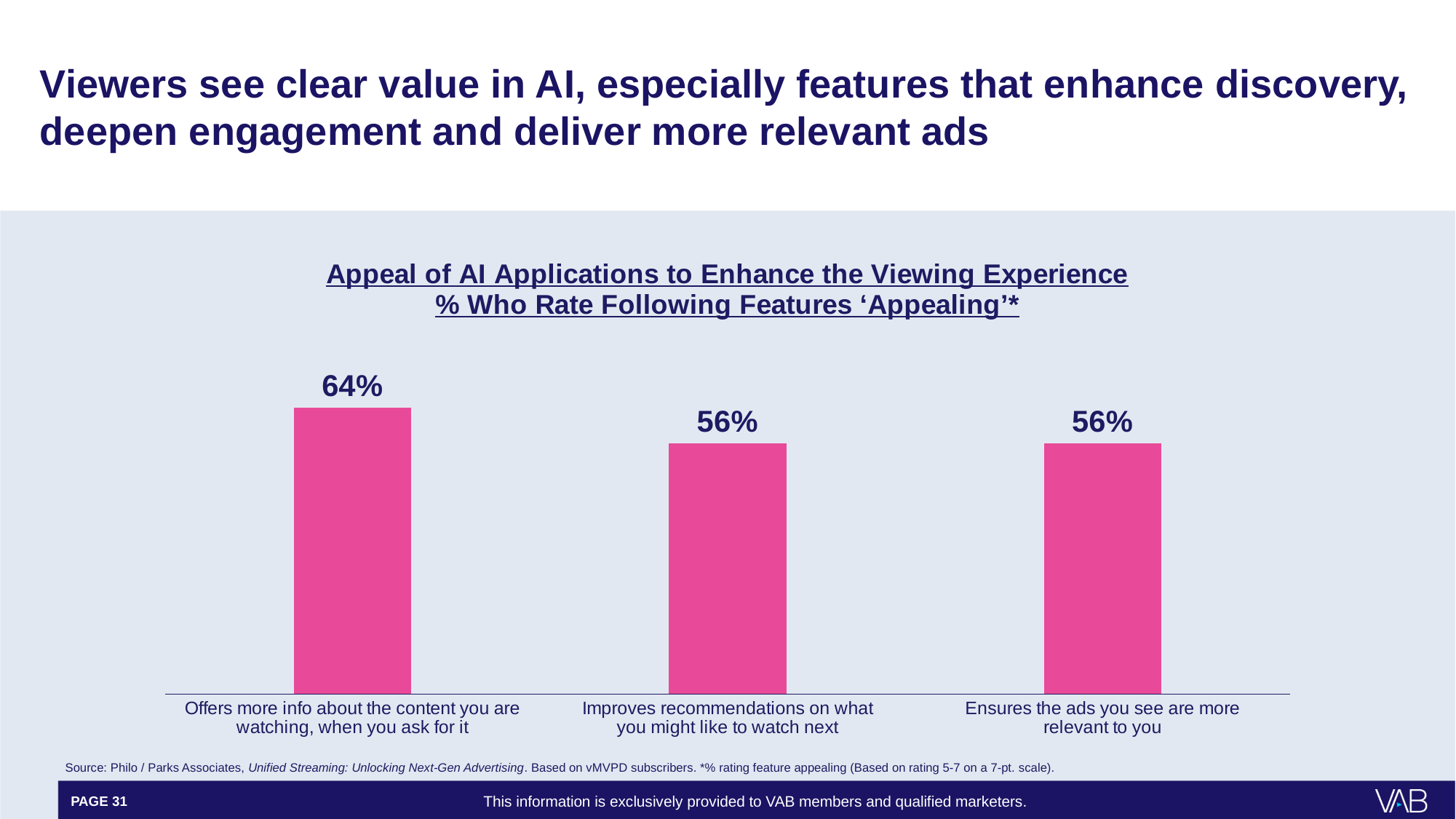
What percentage of viewers rate 'Offers more info about the content you are watching, when you ask for it' as appealing? 64% What colour are the bars in the chart? Pink What type of chart is shown on the slide? Bar chart What is the difference in percentage points between the feature offering more info about content and the feature improving recommendations? 8 Which AI feature has the highest share of viewers rating it appealing? Offers more info about the content you are watching, when you ask for it Do the two features 'Improves recommendations' and 'Ensures the ads you see are more relevant' have the same value? Yes, both 56% Do the values rise or fall from the first bar to the second bar? Fall What is the title of the chart? Appeal of AI Applications to Enhance the Viewing Experience % Who Rate Following Features 'Appealing'* How many AI features are shown in the chart? 3 What percentage of viewers rate 'Improves recommendations on what you might like to watch next' as appealing? 56% What percentage of viewers rate 'Ensures the ads you see are more relevant to you' as appealing? 56% Which is larger: the value for 'Offers more info about the content you are watching' or the value for 'Ensures the ads you see are more relevant to you'? Offers more info about the content you are watching, when you ask for it